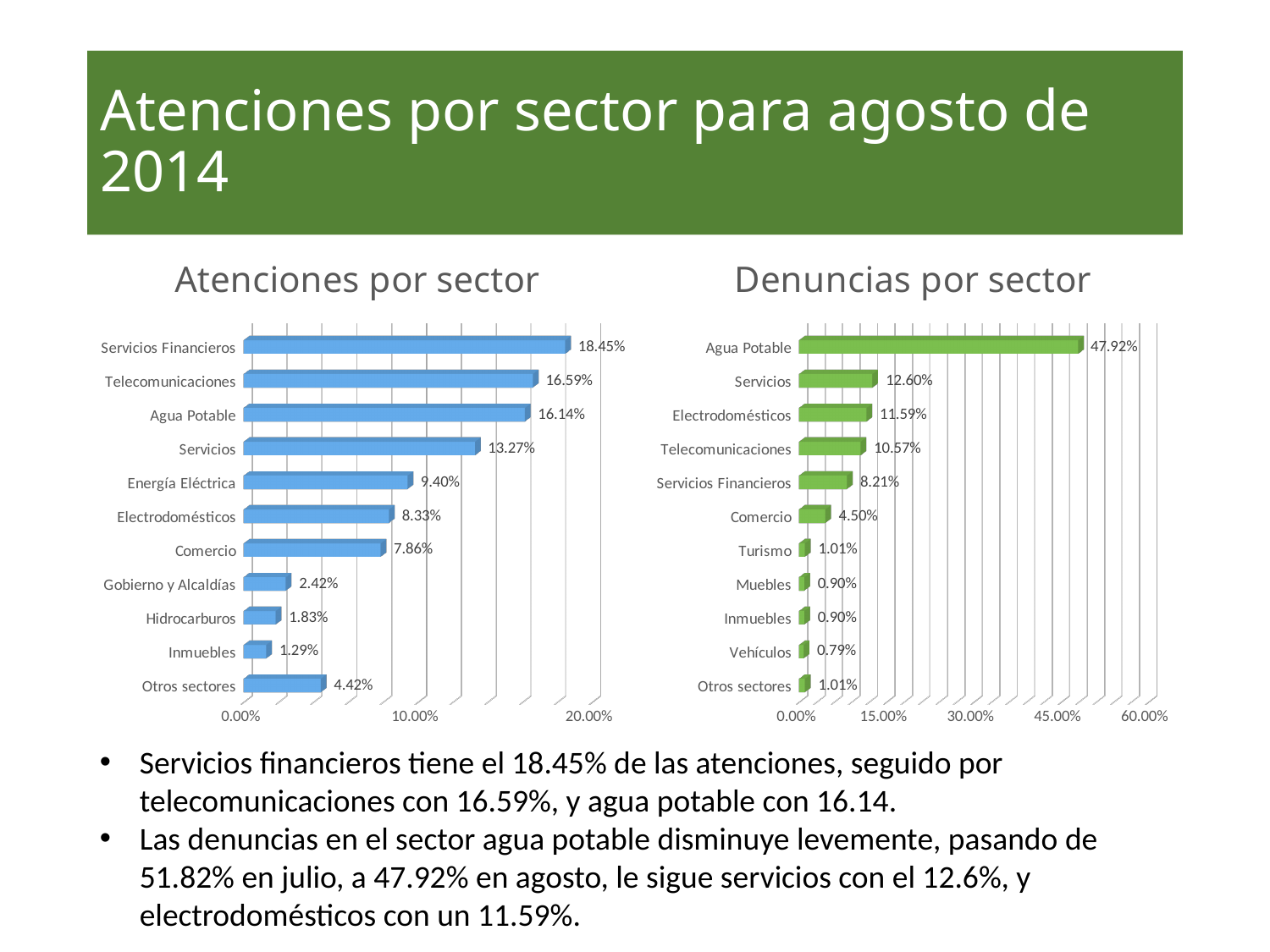
What is the title of the chart on the right side of the slide? Denuncias por sector In the 'Denuncias por sector' chart, is the value for Agua Potable greater or less than 45.00%? greater How many sectors are shown in the 'Denuncias por sector' chart? 11 In the 'Denuncias por sector' chart, which sector has the lowest value? Vehículos What type of chart is 'Atenciones por sector'? Bar chart In the 'Denuncias por sector' chart, what is the difference between Agua Potable and Servicios? 35.32% In the 'Atenciones por sector' chart, what is the difference between Servicios Financieros and Agua Potable? 2.31% In the 'Atenciones por sector' chart, which is larger: Energía Eléctrica or Comercio? Energía Eléctrica In the 'Denuncias por sector' chart, what is the value for Electrodomésticos? 11.59% In the 'Atenciones por sector' chart, what is the value for Telecomunicaciones? 16.59% In the 'Atenciones por sector' chart, which sector has the highest value? Servicios Financieros In the 'Atenciones por sector' chart, which sector has the lowest value? Inmuebles